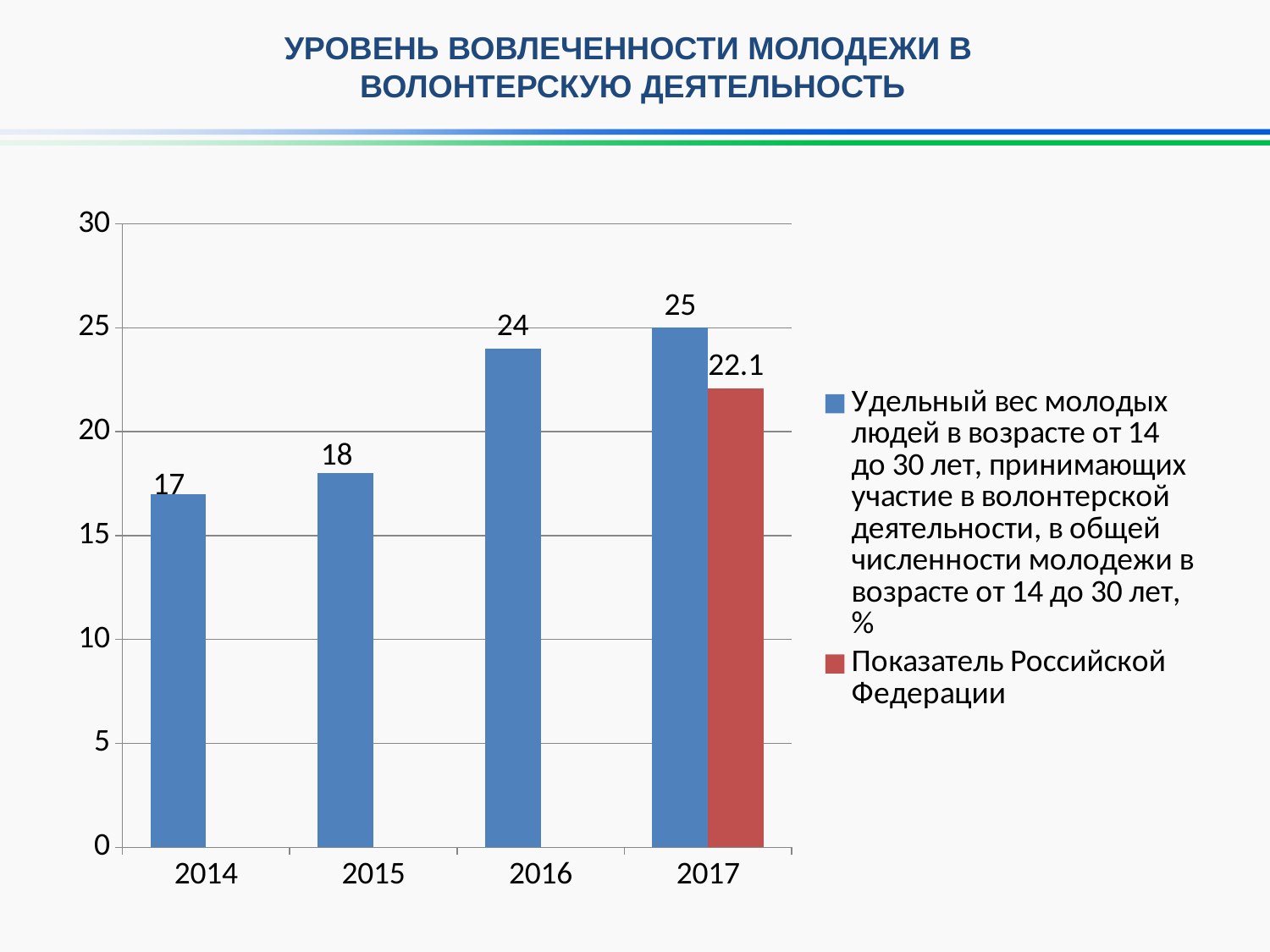
Which year has the highest value for the blue series? 2017 In 2017, which is larger: the blue series value or the red series value (Показатель Российской Федерации)? The blue series value (25) What is the value of the blue series for 2016? 24 Is the blue series value for 2015 greater or less than 20? less How many years are shown on the x axis? 4 How many series does the legend list? 2 What is the value of the blue series (share of young people participating in volunteer activity) for 2014? 17 Do the blue series values rise or fall from 2014 to 2017? Rise What is the value of the red series (Показатель Российской Федерации) for 2017? 22.1 What kind of chart is shown on the slide? Bar chart What is the difference between the blue series values for 2017 and 2014? 8 Which year has the lowest value for the blue series? 2014